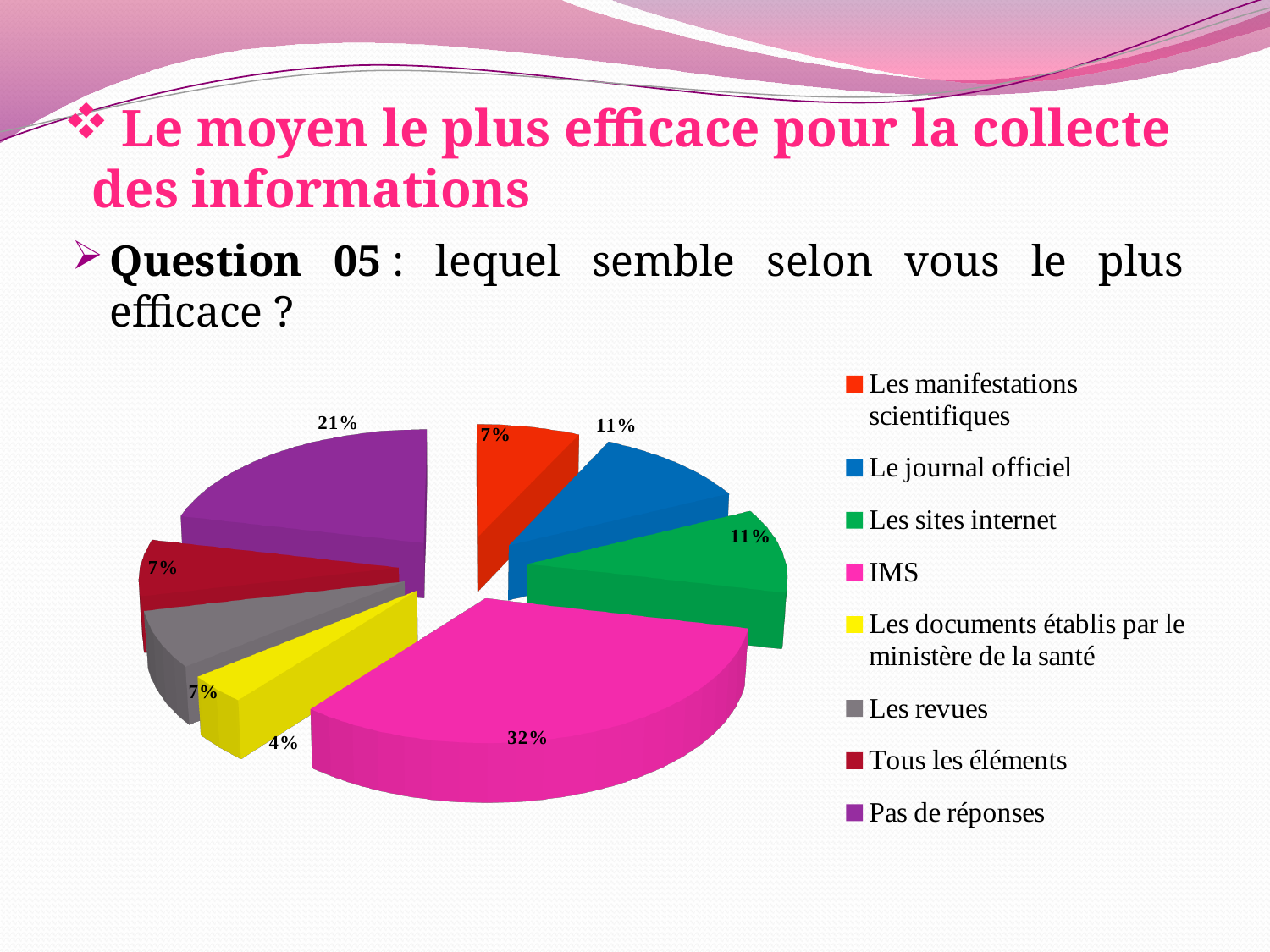
How many categories does the legend of the pie chart list? 8 Which category has the largest slice of the pie? IMS What is the value shown for Le journal officiel? 11% What is the value shown for Les documents établis par le ministère de la santé? 4% Which colour represents IMS in the pie chart? pink What is the value shown for Les revues? 7% What kind of chart is shown on the slide? pie chart Which category has the smallest slice of the pie? Les documents établis par le ministère de la santé What is the value shown for Pas de réponses? 21% Which is larger, the share for Les sites internet or the share for Tous les éléments? Les sites internet What is the difference between the share for IMS and the share for Pas de réponses? 11% What share of the pie does IMS represent? 32%